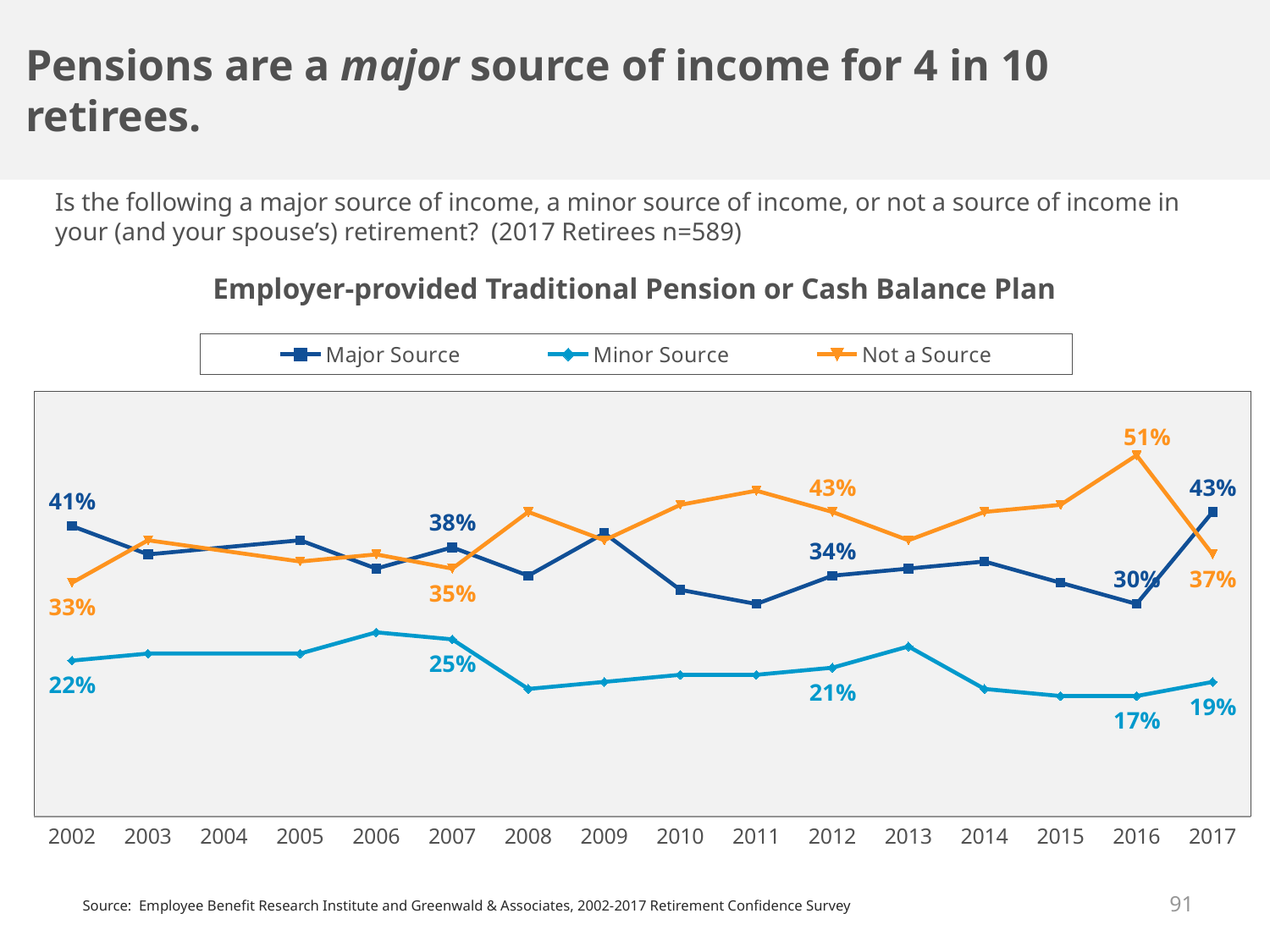
How many series does the legend list? 3 Which is larger in 2012: the Major Source value or the Not a Source value? Not a Source Does the Minor Source line rise or fall from 2002 to 2016? fall What is the title of the chart? Employer-provided Traditional Pension or Cash Balance Plan What is the value for Minor Source in 2012? 21% What kind of chart is shown on the slide? line chart What is the value for Not a Source in 2007? 35% What is the value for Not a Source in 2016? 51% How many years are shown on the x axis? 16 What is the value for Major Source in 2017? 43% What is the difference between the Not a Source value in 2016 and the Not a Source value in 2017? 14% What is the value for Minor Source in 2002? 22%